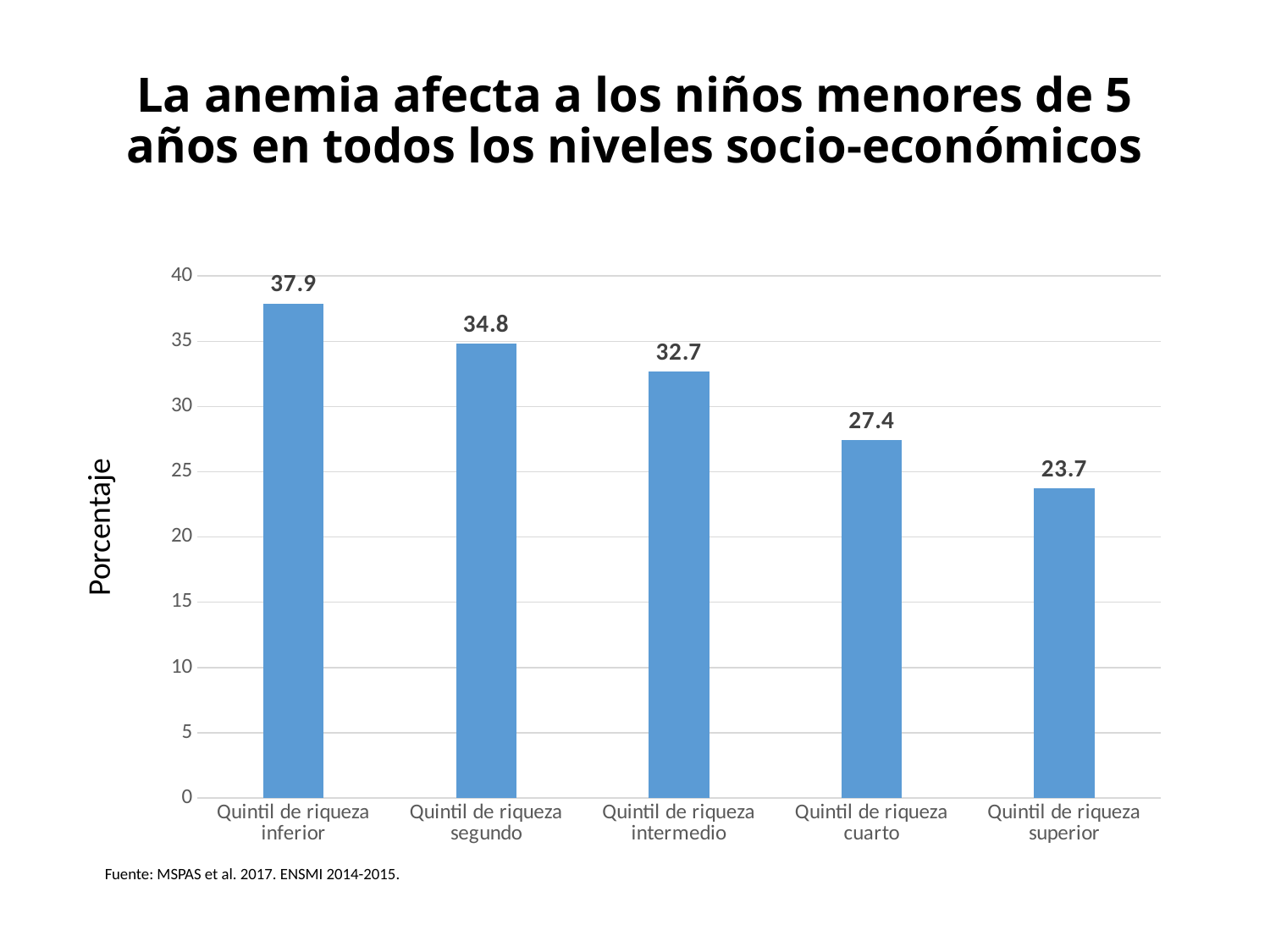
What is the difference between the values for Quintil de riqueza inferior and Quintil de riqueza superior? 14.2 What is the value for Quintil de riqueza intermedio? 32.7 Which category has the lowest value? Quintil de riqueza superior Which is larger, the value for Quintil de riqueza segundo or Quintil de riqueza cuarto? Quintil de riqueza segundo Which category has the highest value? Quintil de riqueza inferior Do the values rise or fall from Quintil de riqueza inferior to Quintil de riqueza superior? fall What is the value for Quintil de riqueza inferior? 37.9 What kind of chart is shown on the slide? bar chart Is the value for Quintil de riqueza cuarto greater or less than 30? less What is the difference between the values for Quintil de riqueza segundo and Quintil de riqueza cuarto? 7.4 What is the value for Quintil de riqueza superior? 23.7 How many categories are shown in the chart? 5